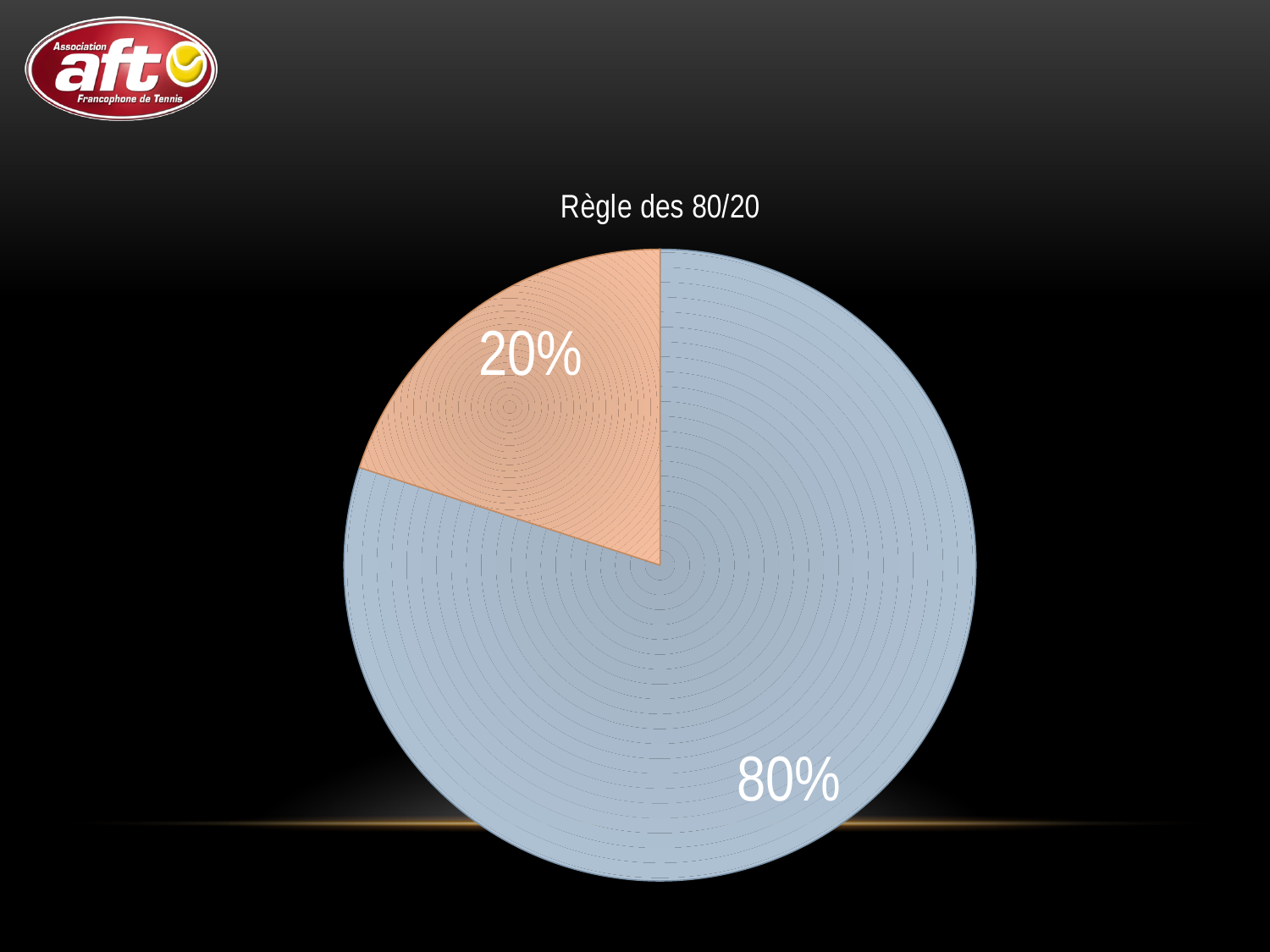
What share of the pie does the blue slice represent? 80% What is the title of the chart? Règle des 80/20 How many slices does the pie chart have? 2 What is the difference in percentage points between the blue slice and the orange slice? 60 Which is larger, the blue slice or the orange slice? the blue slice What colour is the slice labelled 20%? orange Which slice is the smallest in the pie chart? the orange slice (20%) What share of the pie does the orange slice represent? 20% What kind of chart is shown on the slide? pie chart Which slice is the largest in the pie chart? the blue slice (80%) What is the total of the two slice percentages shown on the pie chart? 100%